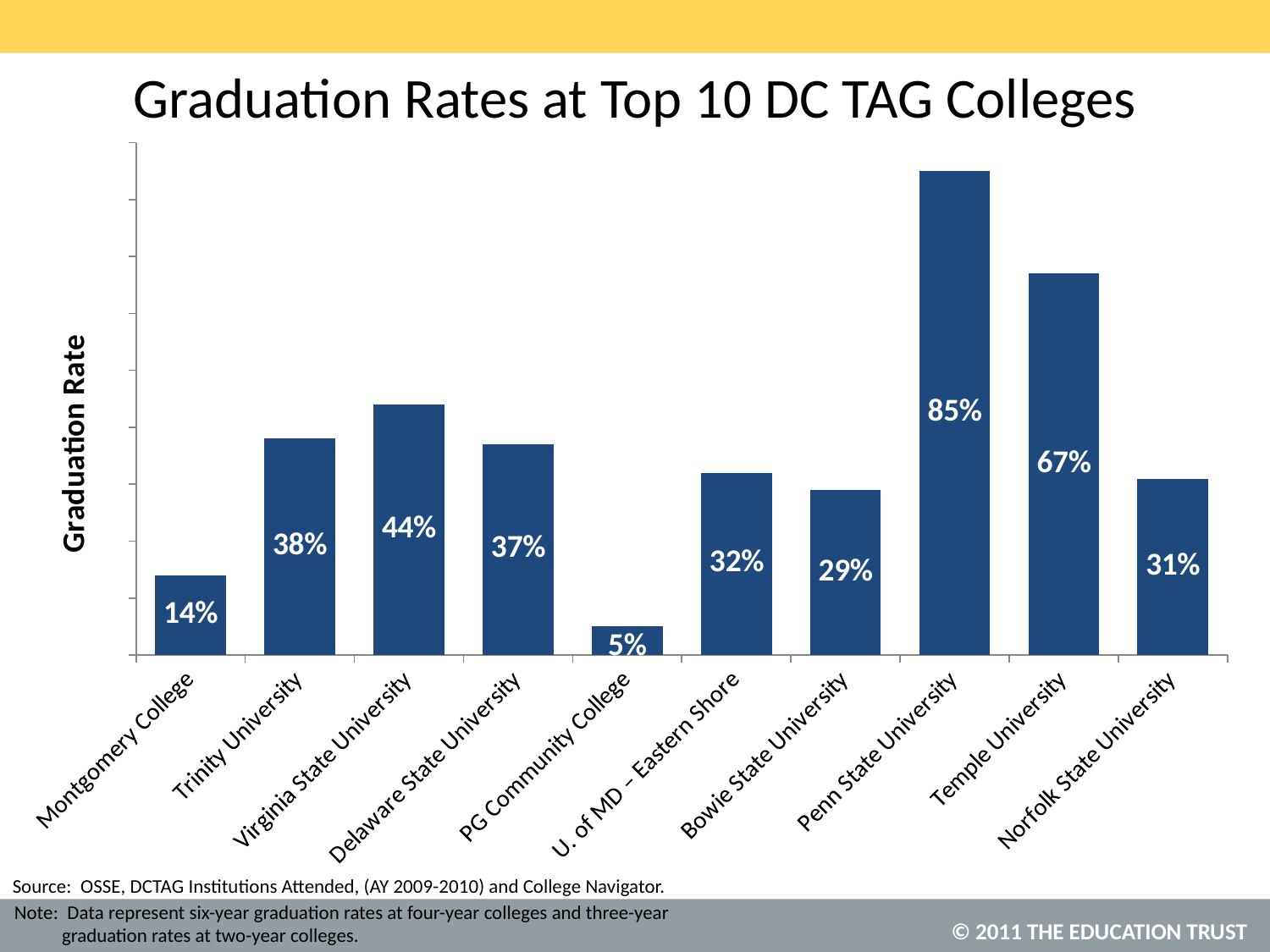
What is the graduation rate for Montgomery College? 14% Which has a higher graduation rate, U. of MD – Eastern Shore or Delaware State University? Delaware State University What kind of chart is shown on the slide? Bar chart What is the graduation rate for Penn State University? 85% What is the title of the chart? Graduation Rates at Top 10 DC TAG Colleges What is the graduation rate for Delaware State University? 37% Which college has the lowest graduation rate? PG Community College Which has a higher graduation rate, Bowie State University or Norfolk State University? Norfolk State University Which college has the highest graduation rate? Penn State University What is the difference between the graduation rates of Virginia State University and Trinity University? 6% What is the difference between the graduation rates of Penn State University and Temple University? 18% How many colleges are shown in the chart? 10